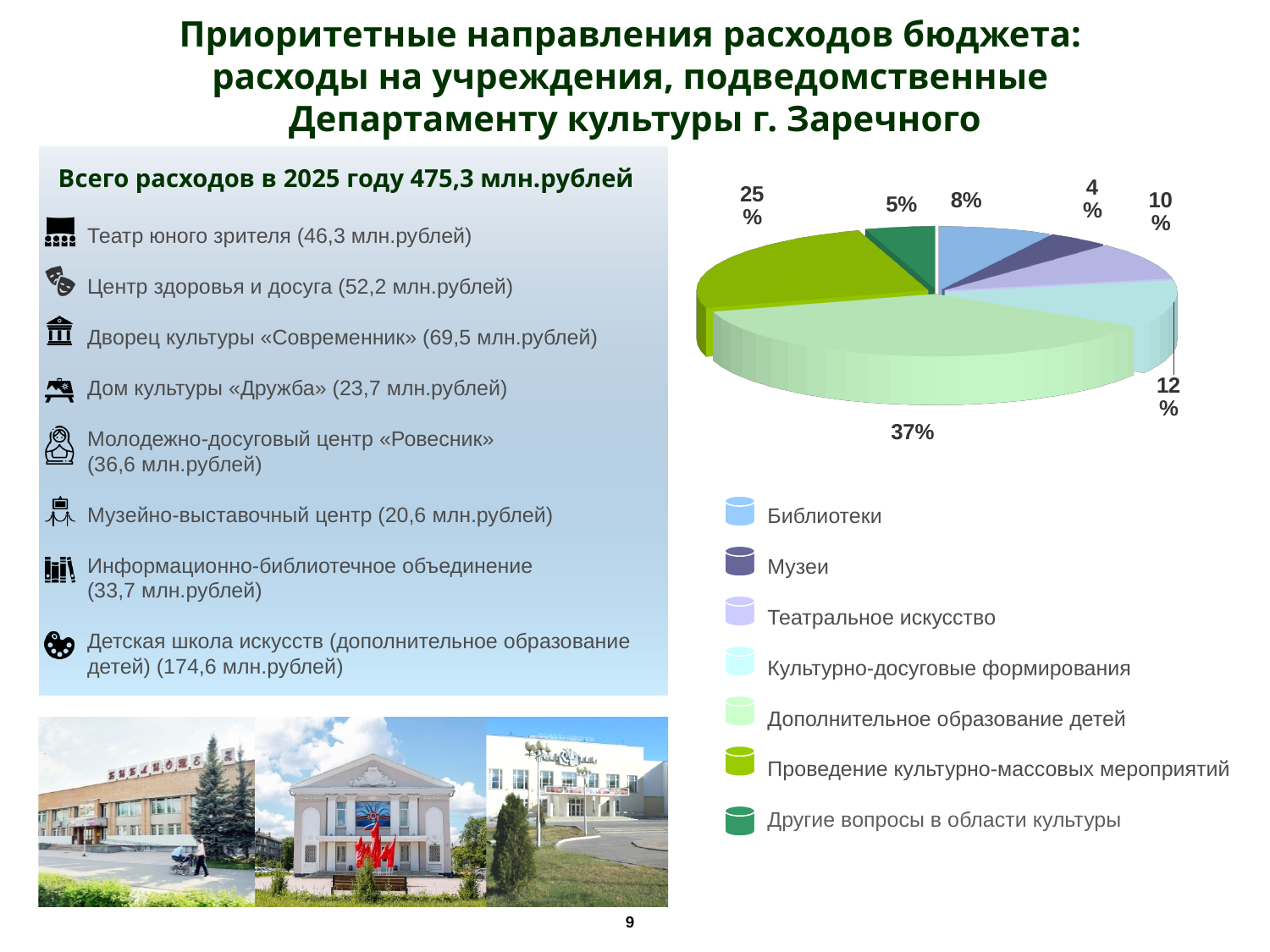
Which category has the largest slice of the pie chart? Дополнительное образование детей What share of the pie chart is labelled for Дополнительное образование детей? 37% What share of the pie chart is labelled for Музеи? 4% What share of the pie chart is labelled for Библиотеки? 8% What kind of chart is shown on the slide? pie chart Which slice is larger: Театральное искусство or Другие вопросы в области культуры? Театральное искусство What share of the pie chart is labelled for Проведение культурно-массовых мероприятий? 25% What is the total expenditure for 2025 stated on the slide? 475,3 млн.рублей Which category has the smallest slice of the pie chart? Музеи What is the difference in percentage points between the slices for Дополнительное образование детей and Проведение культурно-массовых мероприятий? 12 What share of the pie chart is labelled for Культурно-досуговые формирования? 12% How many categories does the legend of the pie chart list? 7